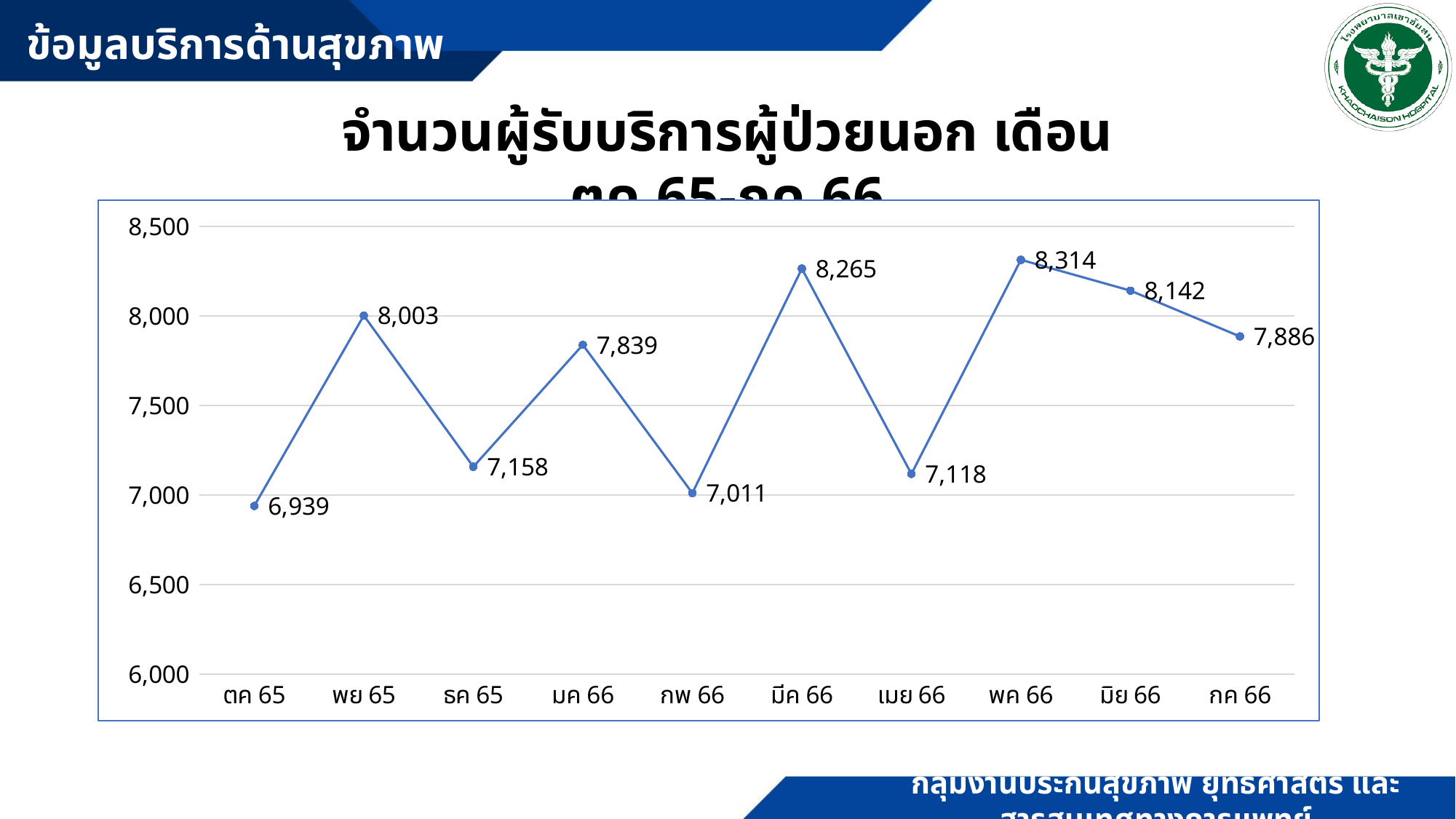
Is the value for เมย 66 greater or less than 7,500? less What is the difference between the values for พค 66 and มิย 66? 172 What is the value for ตค 65? 6,939 Which is larger, the value for มค 66 or the value for กพ 66? มค 66 Does the value rise or fall from พค 66 to กค 66? fall What kind of chart is shown on the slide? line chart How many months are plotted on the chart? 10 What is the value for กค 66? 7,886 Which month has the lowest value? ตค 65 Which month has the highest value? พค 66 What is the value for มีค 66? 8,265 What is the difference between the values for พย 65 and ธค 65? 845